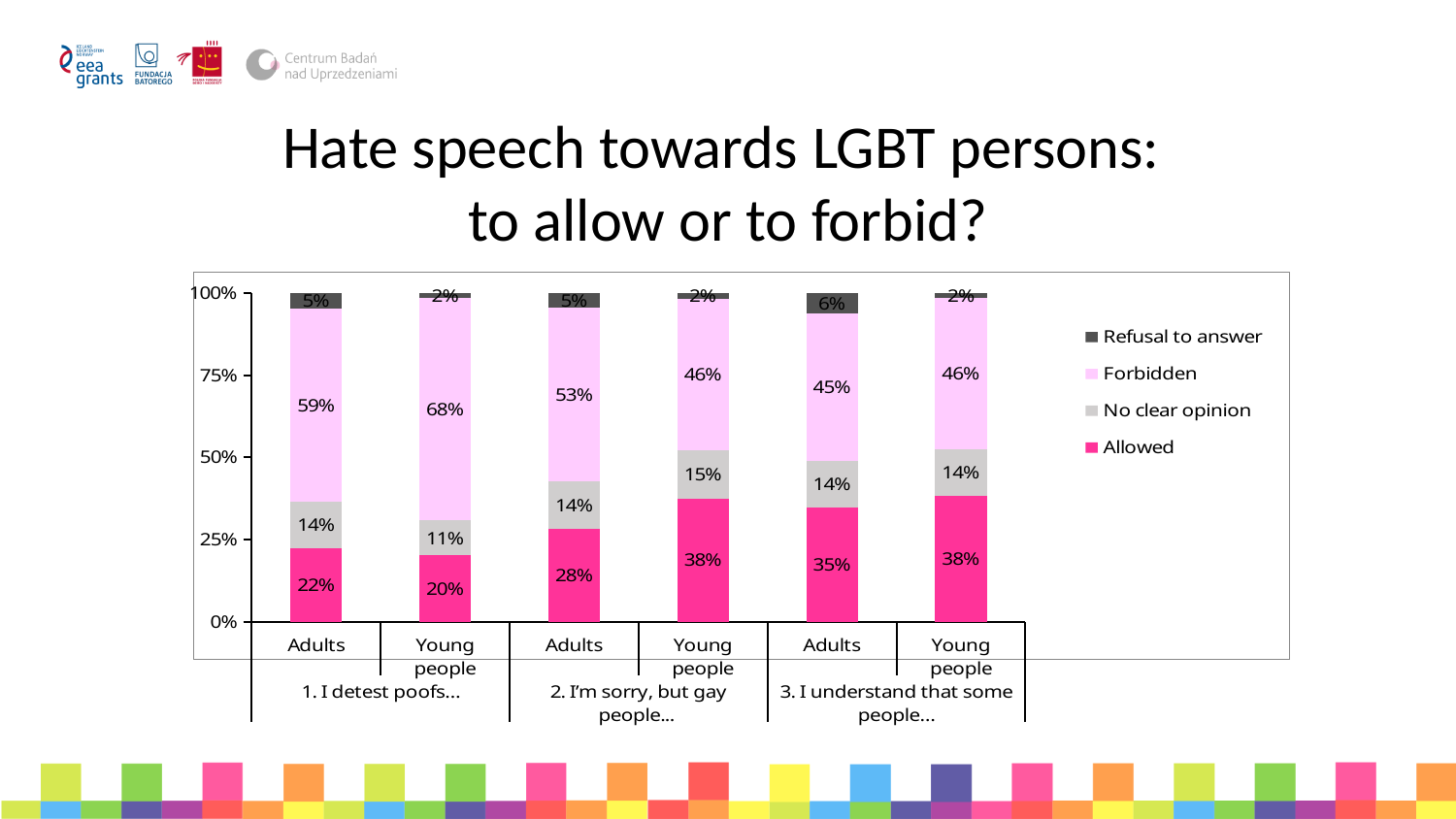
Which bar has the highest 'Forbidden' value? Young people, statement 1 (I detest poofs...) How many series does the legend list? 4 What is the 'No clear opinion' value for young people for statement 2 ('I'm sorry, but gay people...')? 15% What percentage of adults said hate speech should be 'Allowed' for statement 1 ('I detest poofs...')? 22% What is the title of the chart on the slide? Hate speech towards LGBT persons: to allow or to forbid? What kind of chart is shown on the slide? stacked bar chart What is the difference between the 'Allowed' values for young people and adults for statement 2 ('I'm sorry, but gay people...')? 10% Which bar has the lowest 'Allowed' value? Young people, statement 1 (I detest poofs...) For statement 3 ('I understand that some people...'), is the 'Allowed' value larger for adults or for young people? Young people How many bars are plotted in the chart? 6 What is the 'Refusal to answer' value for adults for statement 3 ('I understand that some people...')? 6% What is the 'Forbidden' value for young people for statement 1 ('I detest poofs...')? 68%